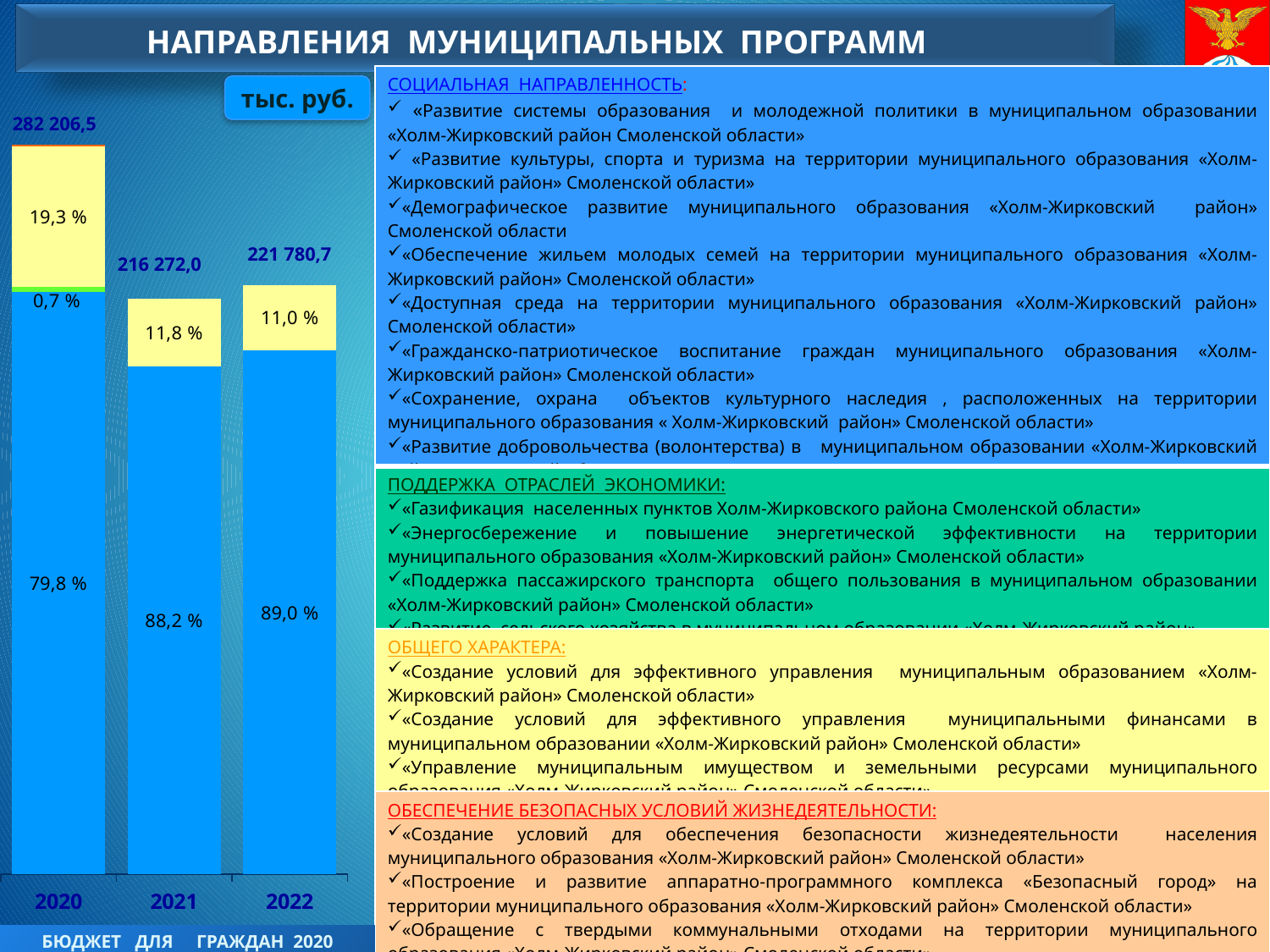
What unit of measurement is indicated in the box above the chart? тыс. руб. Which year has the highest total value? 2020 What percentage is labelled on the green segment of the 2020 bar? 0,7 % What is the total value shown above the 2020 bar? 282 206,5 Which year has the lowest total value? 2021 What is the difference between the total for 2022 and the total for 2021? 5 508,7 What kind of chart is shown on the left of the slide? stacked bar chart How many bars (years) does the chart show? 3 What percentage is labelled on the yellow segment of the 2021 bar? 11,8 % What is the total value shown above the 2021 bar? 216 272,0 What percentage is labelled on the blue segment of the 2020 bar? 79,8 % What is the total value shown above the 2022 bar? 221 780,7